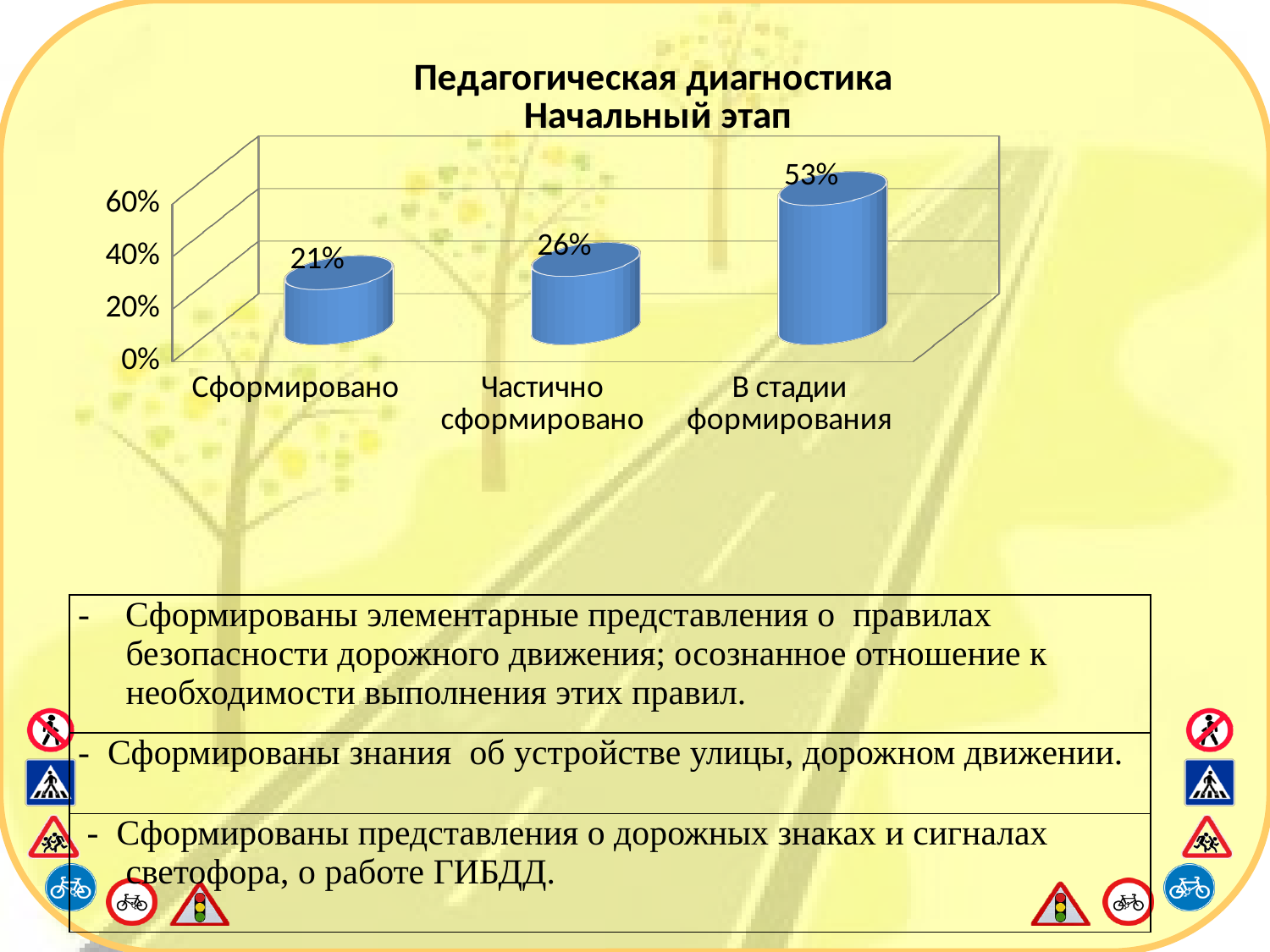
What is the value for Сформировано? 21% Which category has the lowest value? Сформировано Which is larger, the value for Частично сформировано or the value for Сформировано? Частично сформировано What is the difference between the values for Частично сформировано and Сформировано? 5% What is the value for Частично сформировано? 26% What is the value for В стадии формирования? 53% Which category has the highest value? В стадии формирования Is the value for В стадии формирования greater or less than 40%? greater What is the difference between the values for В стадии формирования and Сформировано? 32% How many categories are shown in the chart? 3 What is the title of the chart? Педагогическая диагностика Начальный этап What kind of chart is shown on the slide? bar chart